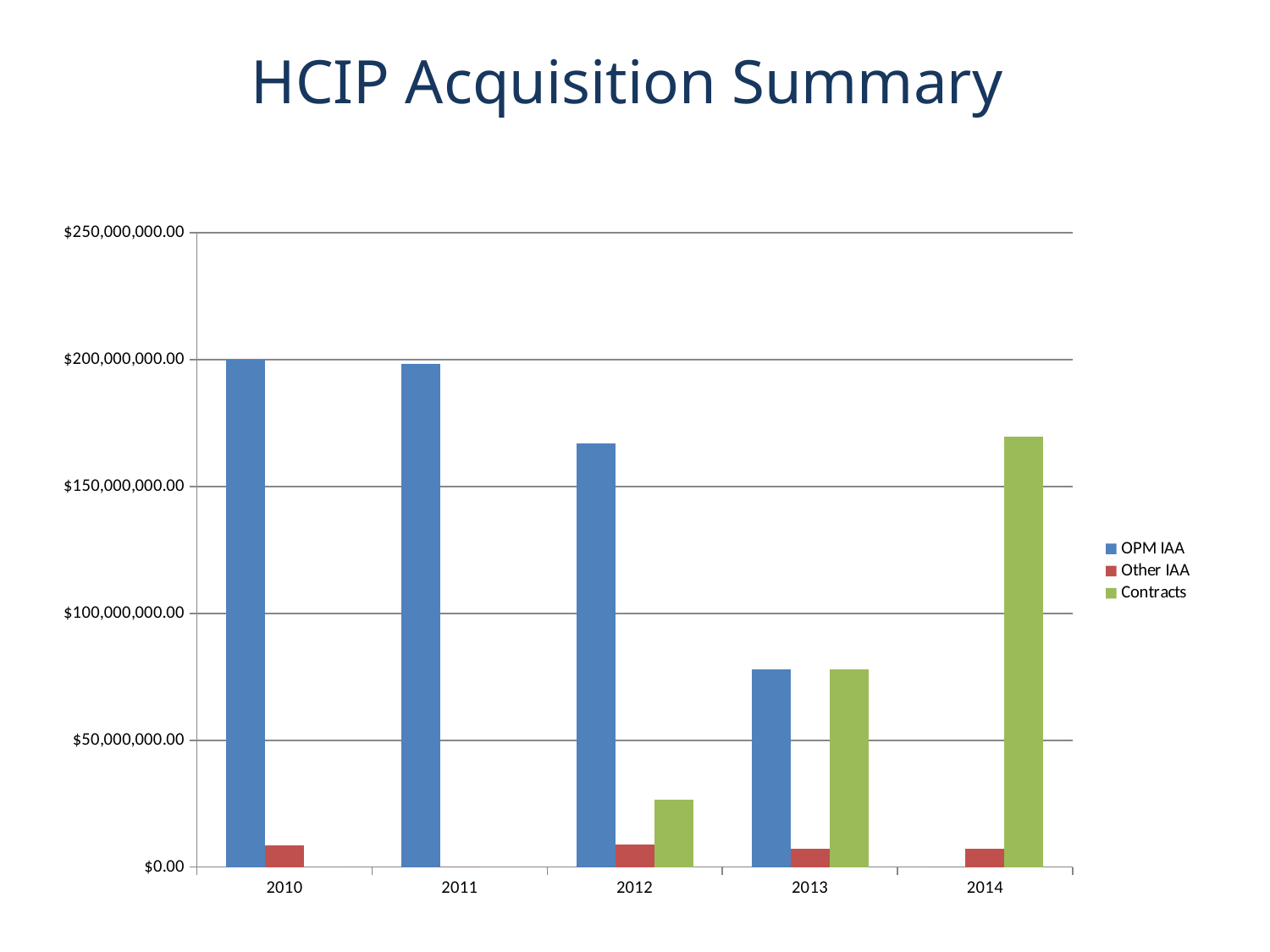
Which is larger, the Contracts value for 2013 or the Contracts value for 2014? 2014 In 2012, which is larger, OPM IAA or Contracts? OPM IAA What kind of chart is shown on the slide? Bar chart Is the OPM IAA value for 2012 greater or less than $150,000,000.00? greater What is the title of the chart? HCIP Acquisition Summary Do the OPM IAA values rise or fall from 2010 to 2013? Fall Which year has the highest Contracts value? 2014 How many series does the legend list? 3 Is the OPM IAA value for 2013 greater or less than $100,000,000.00? less Which year has the lowest Contracts value among the years where Contracts is plotted? 2012 How many years are shown on the x axis? 5 Is the Contracts value for 2012 greater or less than $50,000,000.00? less